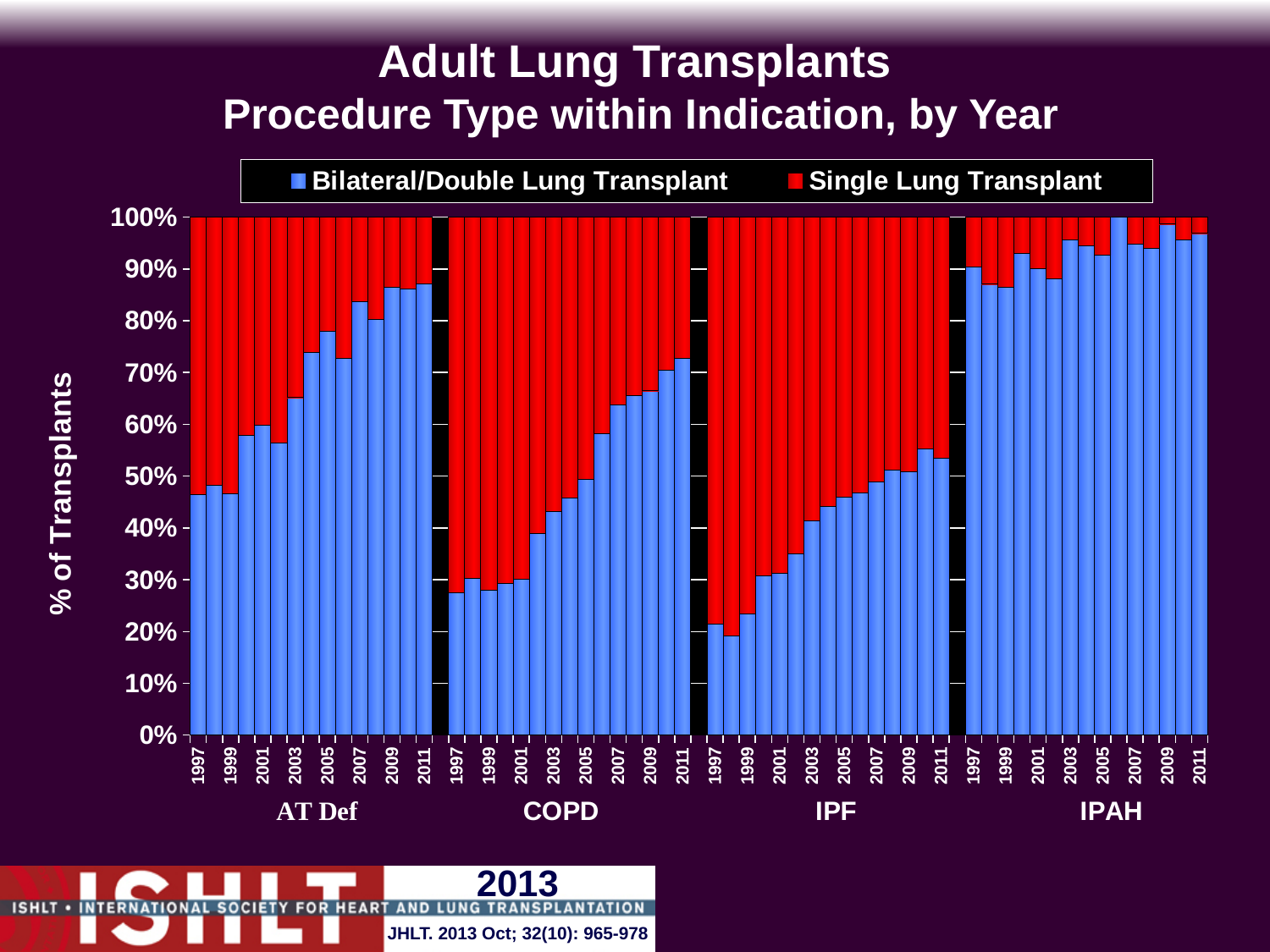
For IPF, does the share of Bilateral/Double Lung Transplant rise or fall from 1997 to 2011? Rise How many indication groups are shown along the x axis? 4 How many yearly bars are shown for the COPD indication? 15 Is the Bilateral/Double Lung Transplant share for COPD in 2011 greater or less than 60%? greater Is the Bilateral/Double Lung Transplant share for IPAH in 1997 greater or less than 80%? greater Which indication has the highest share of Bilateral/Double Lung Transplant in 2011? IPAH How many series does the legend list? 2 What kind of chart is shown on the slide? Stacked bar chart For AT Def, does the share of Bilateral/Double Lung Transplant rise or fall from 1997 to 2011? Rise What is the title of the chart? Adult Lung Transplants Procedure Type within Indication, by Year Is the Bilateral/Double Lung Transplant share for IPF in 1997 greater or less than 30%? less What are the two series named in the legend? Bilateral/Double Lung Transplant and Single Lung Transplant